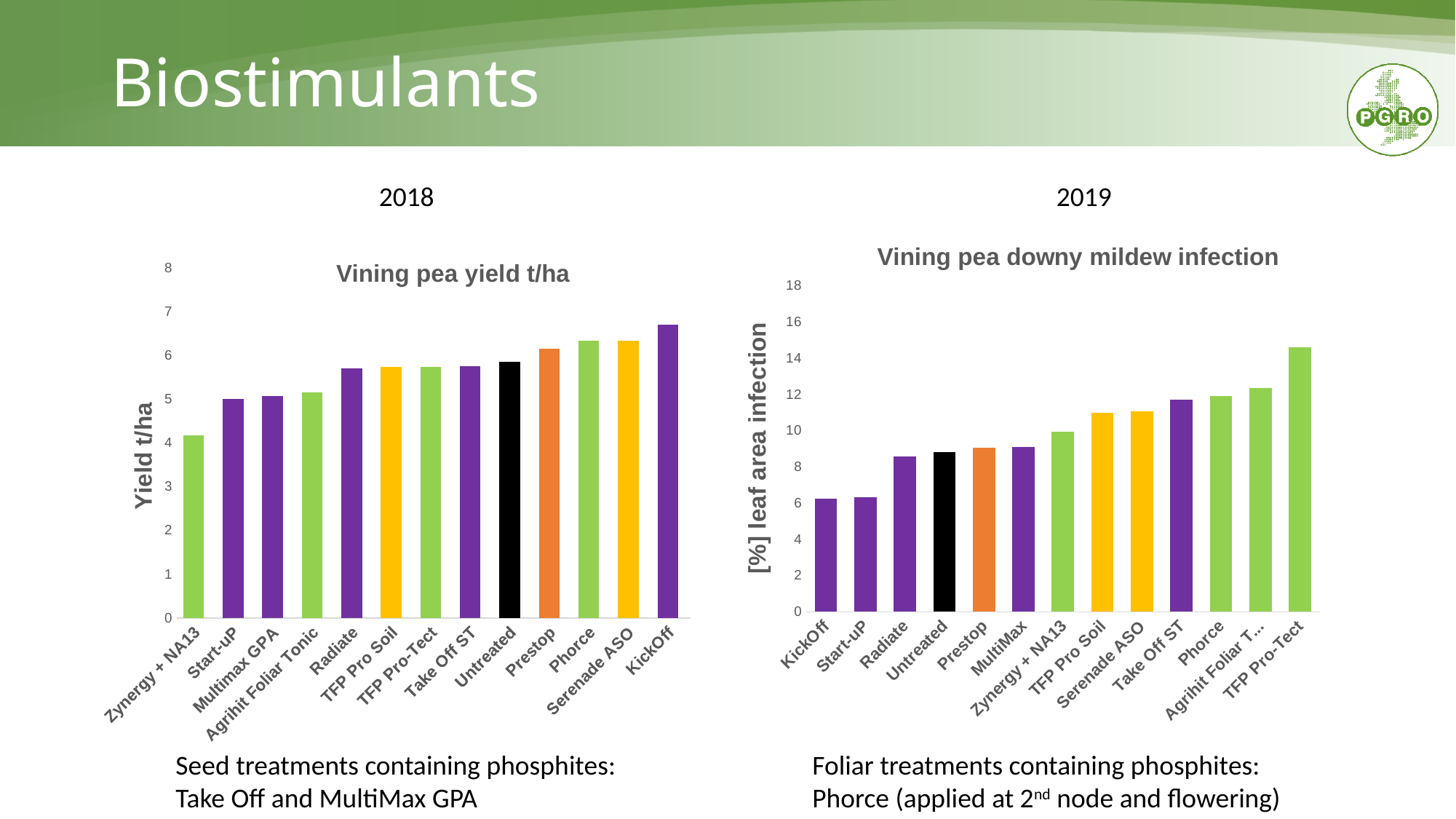
In the 'Vining pea downy mildew infection' chart, is the value for Untreated greater or less than 10? less In the 'Vining pea downy mildew infection' chart, is the value for TFP Pro-Tect greater or less than 12? greater In the 'Vining pea yield t/ha' chart, which treatment has the lowest yield? Zynergy + NA13 In the 'Vining pea yield t/ha' chart, which treatment has the highest yield? KickOff In the 'Vining pea yield t/ha' chart, do the bars rise or fall from left to right? rise In the 'Vining pea yield t/ha' chart, is the value for KickOff greater or less than 6? greater What is the y-axis label of the 'Vining pea downy mildew infection' chart? [%] leaf area infection How many treatments are shown in the 'Vining pea yield t/ha' chart? 13 What type of chart is the 'Vining pea yield t/ha' chart on the left? bar chart In the 'Vining pea downy mildew infection' chart, which treatment has the highest infection? TFP Pro-Tect How many treatments are shown in the 'Vining pea downy mildew infection' chart? 13